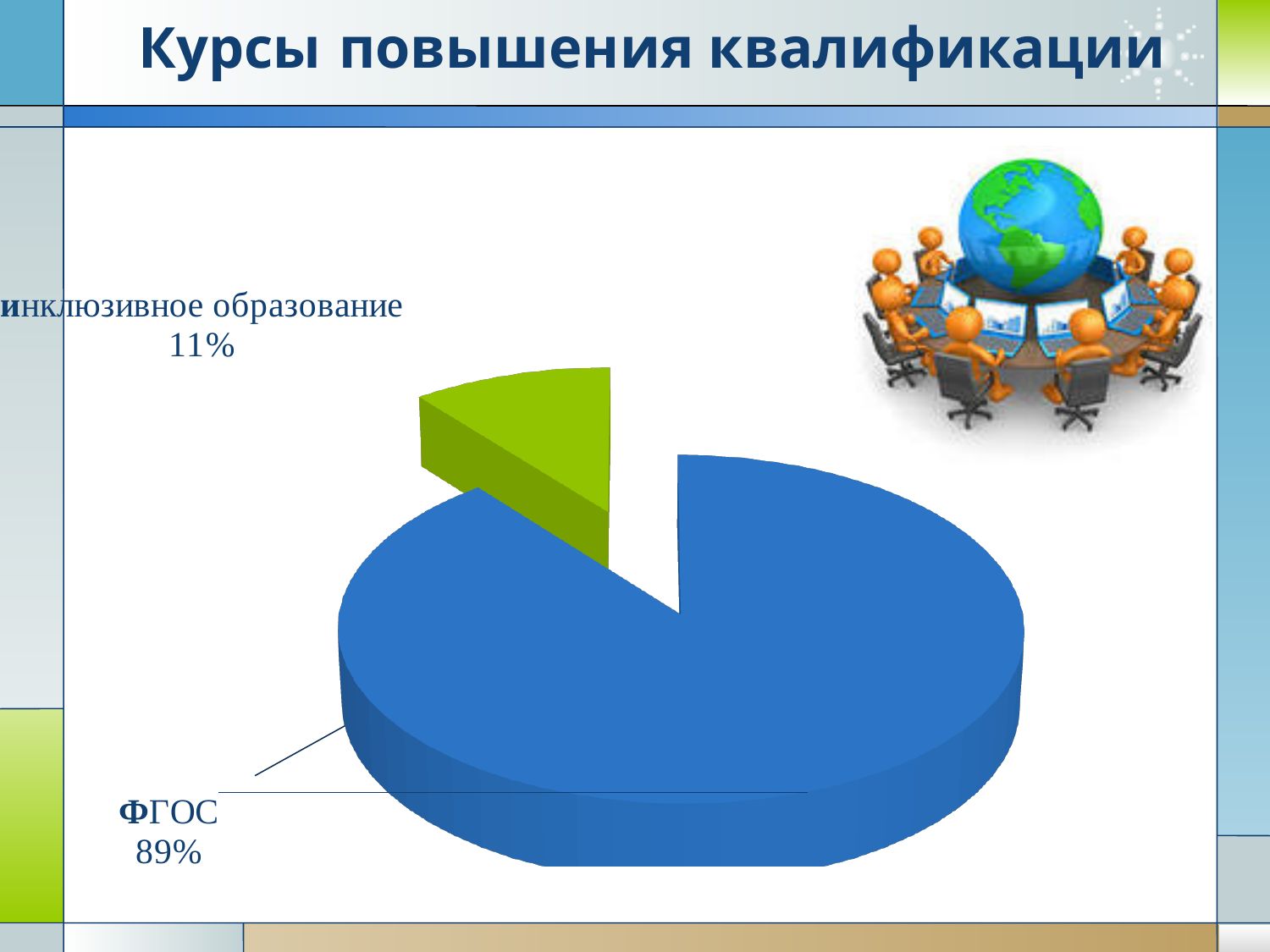
Which category has the largest slice of the pie? ФГОС What share of the pie does ФГОС have? 89% What colour is the slice for инклюзивное образование? green Which is larger, the share for ФГОС or the share for инклюзивное образование? ФГОС What share of the pie does инклюзивное образование have? 11% Which category has the smallest slice of the pie? инклюзивное образование What is the difference in percentage points between ФГОС and инклюзивное образование? 78 How many slices does the pie chart have? 2 What kind of chart is shown on the slide? pie chart What is the title of the slide containing the pie chart? Курсы повышения квалификации